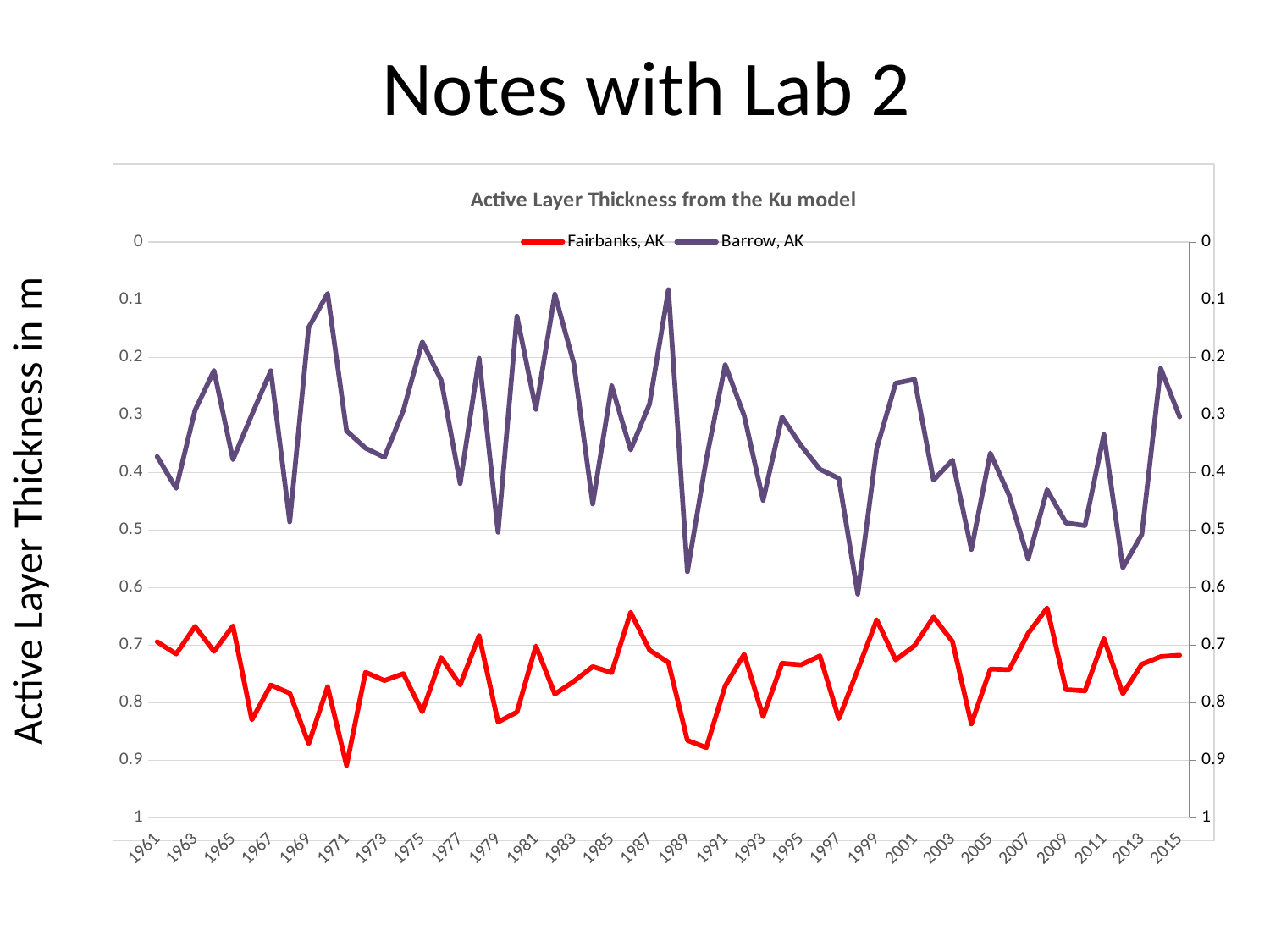
Is the value for Fairbanks, AK in 2008 greater or less than 0.7? less Is the value for Barrow, AK in 1988 greater or less than 0.2? less Which series has the larger values throughout the chart, Fairbanks, AK or Barrow, AK? Fairbanks, AK Is the value for Barrow, AK in 1998 greater or less than 0.5? greater Which series is drawn in red? Fairbanks, AK In 1985, which series has the larger value, Fairbanks, AK or Barrow, AK? Fairbanks, AK How many series does the legend list? 2 What kind of chart is shown on the slide? line chart What is the title of the chart? Active Layer Thickness from the Ku model